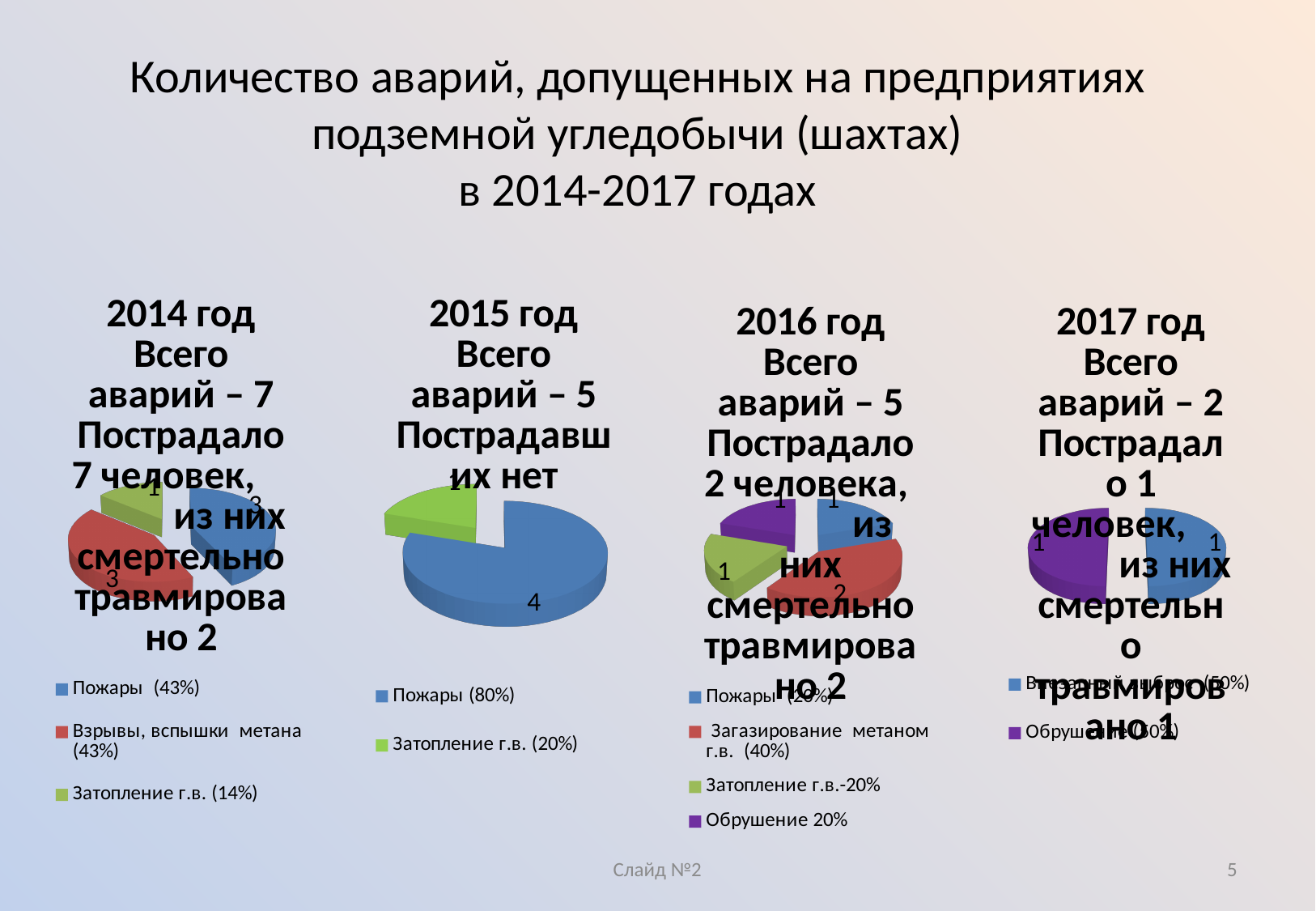
In the 2015 год chart, what is the value for Пожары? 4 How many categories does the legend of the 2014 год chart list? 3 What type of chart is used for the 2014 год chart? pie chart In the 2014 год chart, what is the value for Затопление г.в.? 1 In the 2016 год chart, which category has the largest slice? Загазирование метаном г.в. How many categories does the legend of the 2016 год chart list? 4 In the 2016 год chart, what is the value for Загазирование метаном г.в.? 2 In the 2015 год chart, which category has the largest slice? Пожары In the 2015 год chart, what share of the pie does Затопление г.в. represent? 20% In the 2014 год chart, what share of the pie does Затопление г.в. represent? 14% In the 2014 год chart, what is the value for Пожары? 3 In the 2017 год chart, what is the difference between the values for Внезапный выброс and Обрушение? 0